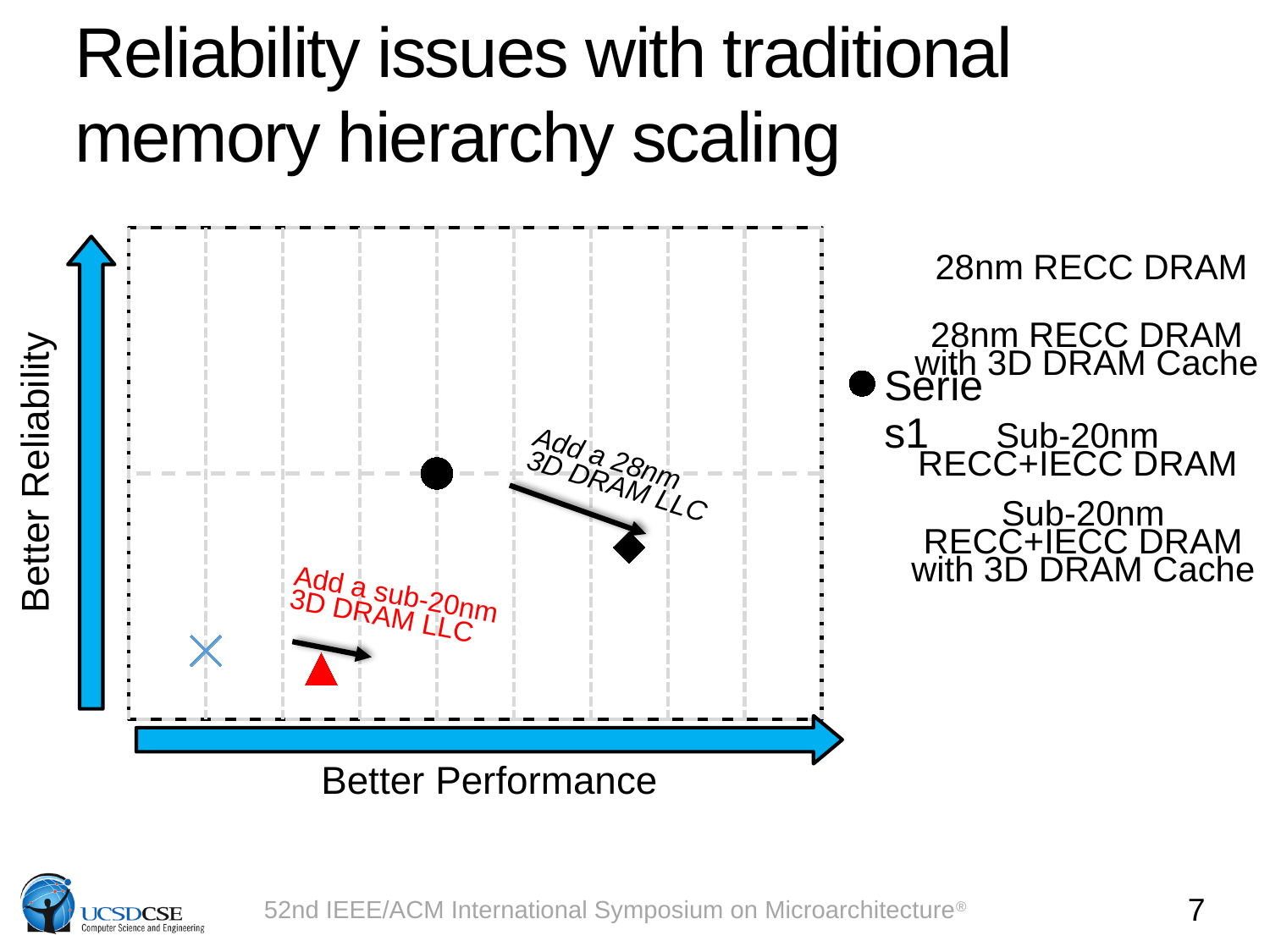
Which marker is plotted highest on the chart (best reliability)? the black circle How many data points are plotted on the chart? 4 What is the label on the vertical axis of the chart? Better Reliability Which marker is plotted furthest to the right on the chart (best performance)? the black diamond What is the label on the horizontal axis of the chart? Better Performance What kind of chart is shown on the slide? scatter chart Is the black diamond plotted to the left or to the right of the black circle on the performance axis? right Is the red triangle plotted to the left or to the right of the blue X on the performance axis? right Which marker is plotted furthest to the left on the chart? the blue X Is the black circle plotted higher or lower on the reliability axis than the black diamond? higher